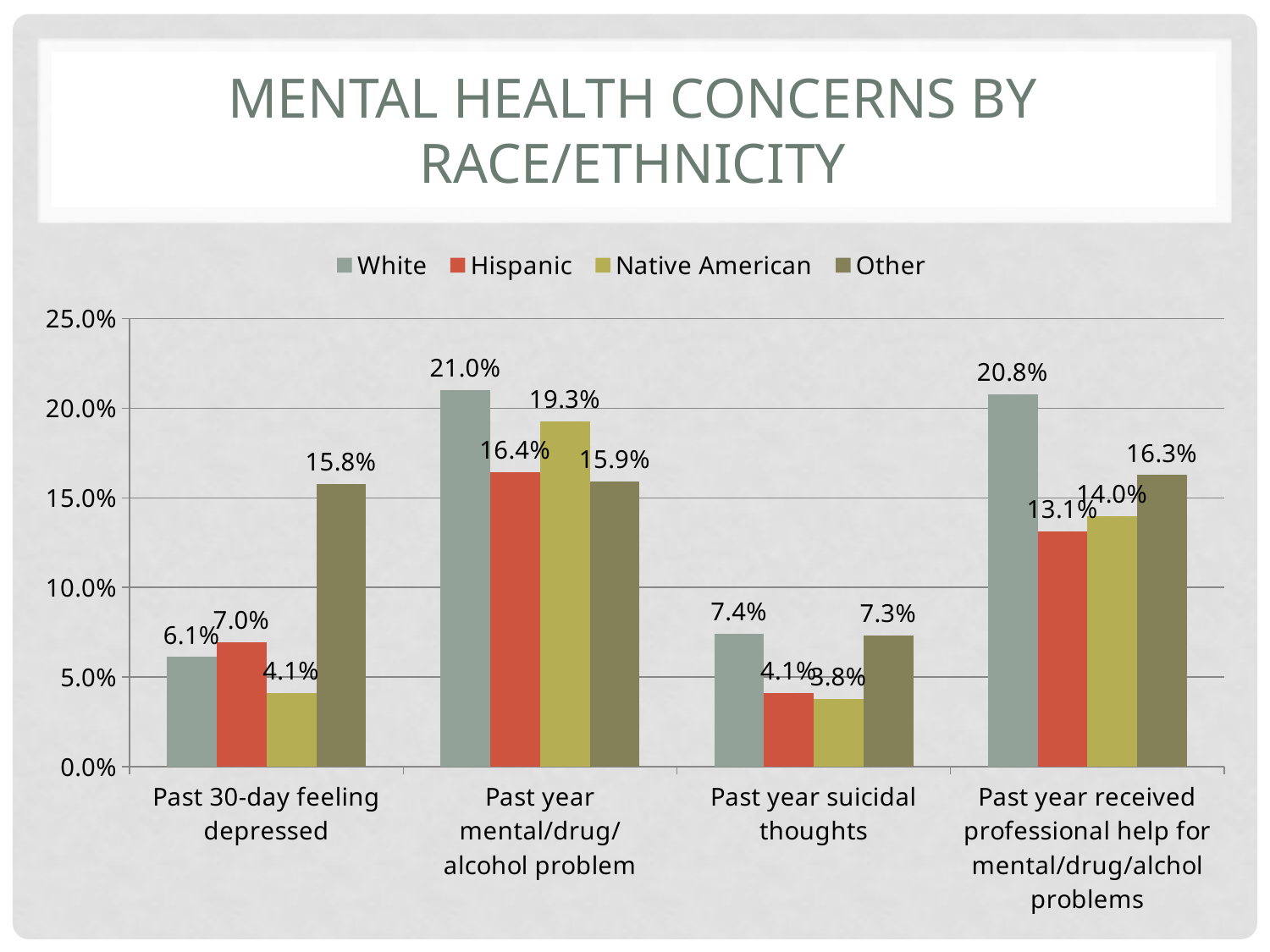
What is the value for Other in the 'Past 30-day feeling depressed' category? 15.8% What kind of chart is shown on the slide? Bar chart How many categories are shown on the x axis? 4 What is the value for Native American in the 'Past year received professional help for mental/drug/alchol problems' category? 14.0% What is the difference between the White and Hispanic values in the 'Past year mental/drug/alcohol problem' category? 4.6% How many series does the legend list? 4 Which race/ethnicity group has the highest value in the 'Past 30-day feeling depressed' category? Other Is the value for Native American in the 'Past year mental/drug/alcohol problem' category greater or less than 15.0%? greater What is the value for White in the 'Past year mental/drug/alcohol problem' category? 21.0% Which race/ethnicity group has the lowest value in the 'Past year received professional help for mental/drug/alchol problems' category? Hispanic What is the value for Hispanic in the 'Past year suicidal thoughts' category? 4.1% Which is larger in the 'Past year received professional help for mental/drug/alchol problems' category: the White value or the Other value? White